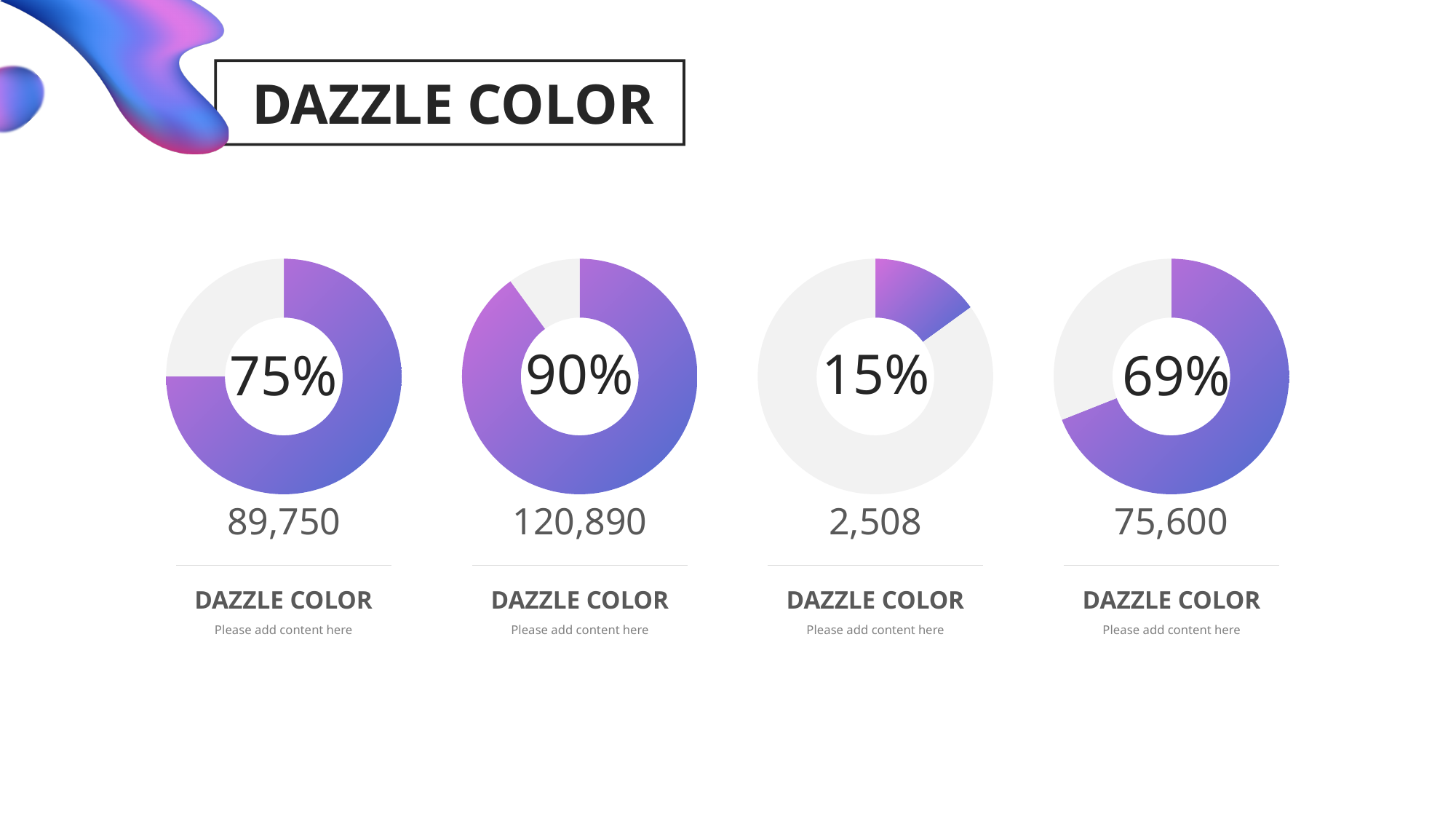
What number is printed below the leftmost donut chart? 89,750 What kind of chart is used on this slide? Donut chart Which donut chart shows the highest percentage? The second from the left (90%) What percentage is shown in the centre of the leftmost donut chart? 75% How many donut charts are on the slide? 4 What percentage is shown in the centre of the third donut chart from the left? 15% What percentage is shown in the centre of the rightmost donut chart? 69% What percentage is shown in the centre of the second donut chart from the left? 90% Which donut chart shows the lowest percentage? The third from the left (15%) What is the difference between the percentage in the leftmost donut chart and the percentage in the rightmost donut chart? 6% What number is printed below the second donut chart from the left? 120,890 What number is printed below the third donut chart from the left? 2,508